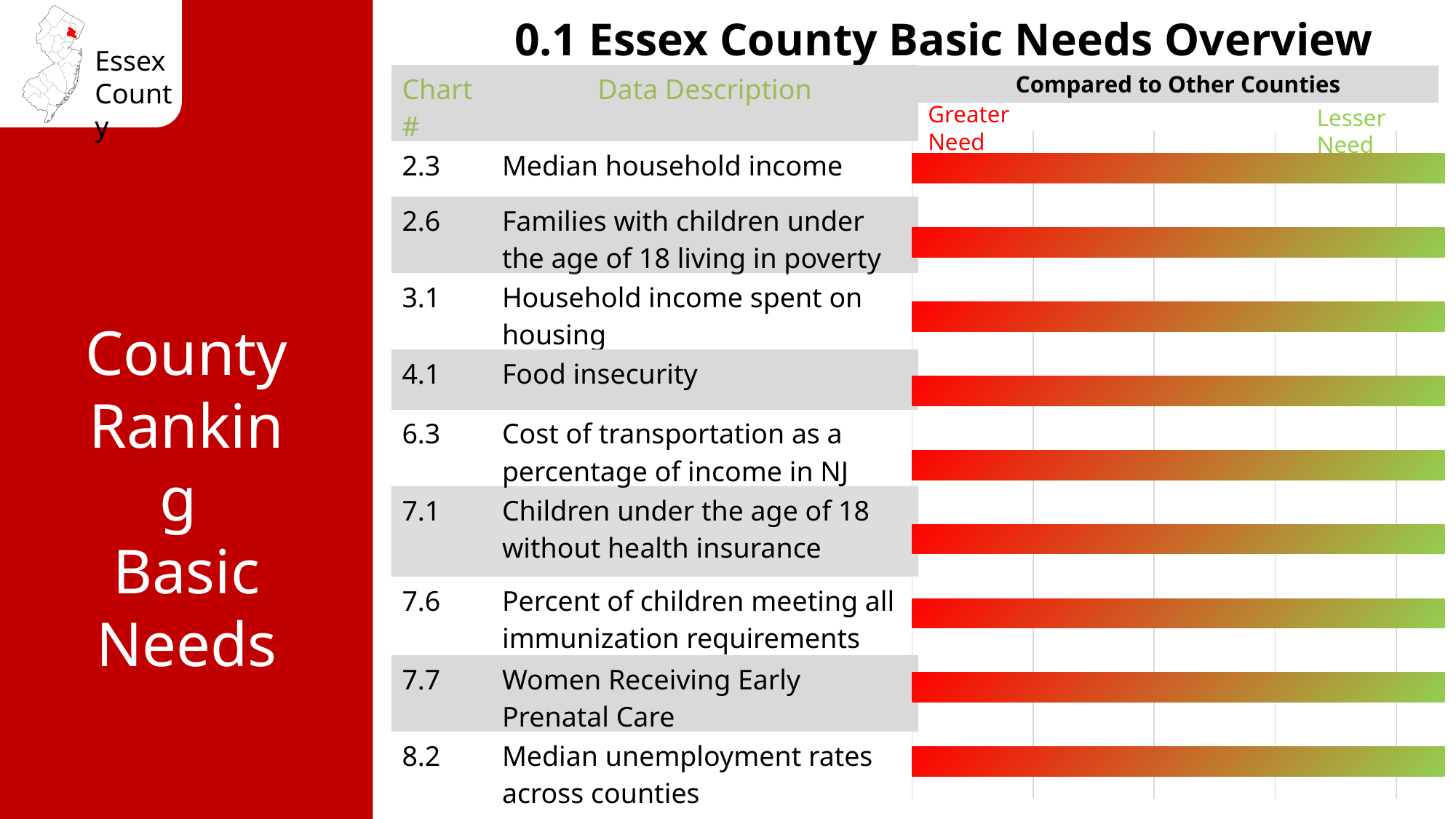
What is the chart number listed for Food insecurity? 4.1 What kind of chart is shown on the slide? bar chart What label appears at the left end of the bar scale? Greater Need Which data description is listed for chart number 2.3? Median household income How many data description rows (bars) are shown in the chart? 9 What is the chart number listed for Median unemployment rates across counties? 8.2 What is the title of the chart on the slide? 0.1 Essex County Basic Needs Overview Which data description is listed for chart number 7.7? Women Receiving Early Prenatal Care